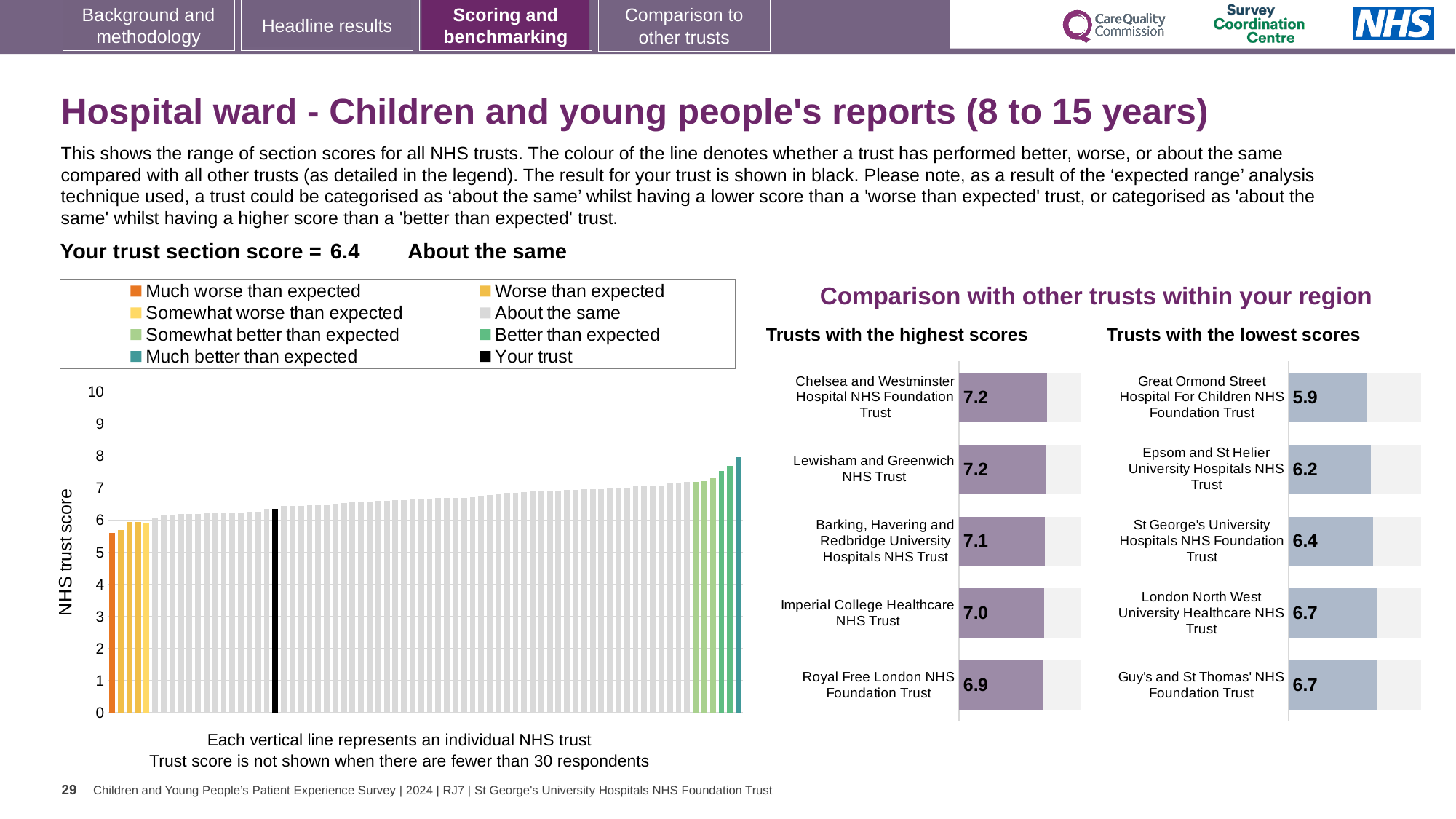
On the 'Trusts with the lowest scores' chart, what is the score for Epsom and St Helier University Hospitals NHS Trust? 6.2 On the 'Trusts with the lowest scores' chart, which trust has the lowest score? Great Ormond Street Hospital For Children NHS Foundation Trust On the 'Trusts with the lowest scores' chart, what is the difference between the scores of London North West University Healthcare NHS Trust and Great Ormond Street Hospital For Children NHS Foundation Trust? 0.8 How many trusts are shown on the 'Trusts with the lowest scores' chart? 5 On the 'Trusts with the highest scores' chart, what is the difference between the scores of Chelsea and Westminster Hospital NHS Foundation Trust and Royal Free London NHS Foundation Trust? 0.3 How many entries does the legend of the NHS trust score chart list? 8 On the 'Trusts with the highest scores' chart, which has the higher score: Barking, Havering and Redbridge University Hospitals NHS Trust or Imperial College Healthcare NHS Trust? Barking, Havering and Redbridge University Hospitals NHS Trust On the 'Trusts with the lowest scores' chart, what is the score for Great Ormond Street Hospital For Children NHS Foundation Trust? 5.9 On the 'Trusts with the highest scores' chart, what is the score for Imperial College Healthcare NHS Trust? 7.0 On the 'Trusts with the highest scores' chart, which trust has the lowest score? Royal Free London NHS Foundation Trust What kind of chart is the NHS trust score chart on the left of the slide? Bar chart On the NHS trust score chart, do the bar values rise or fall from left to right? Rise